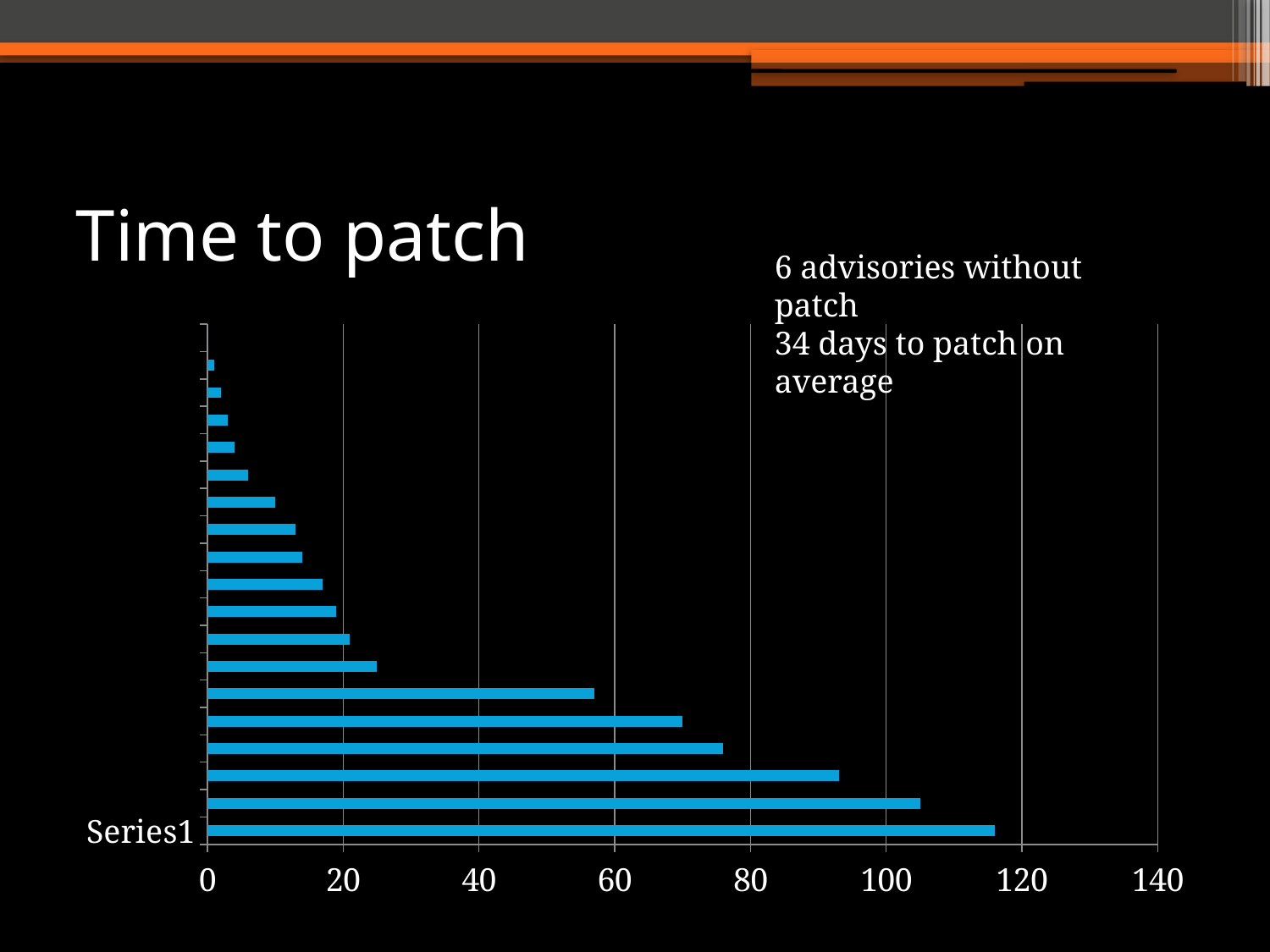
Is the value of the third-longest bar greater or less than 100? less Is the bottom bar (Series1) longer or shorter than the bar directly above it? Longer Is the value of the shortest bar (the top bar) greater or less than 20? less What is the highest value shown on the horizontal axis of the chart? 140 Which bar is the longest in the chart: the top bar or the bottom bar? The bottom bar Do the bar lengths increase or decrease going from the top of the chart to the bottom? Increase Is the value of the second-longest bar greater or less than 100? greater What is the title of the chart on the slide? Time to patch Which bar is the shortest in the chart: the top bar or the bottom bar? The top bar What kind of chart is shown on the slide? Bar chart How many bars are plotted in the chart? 18